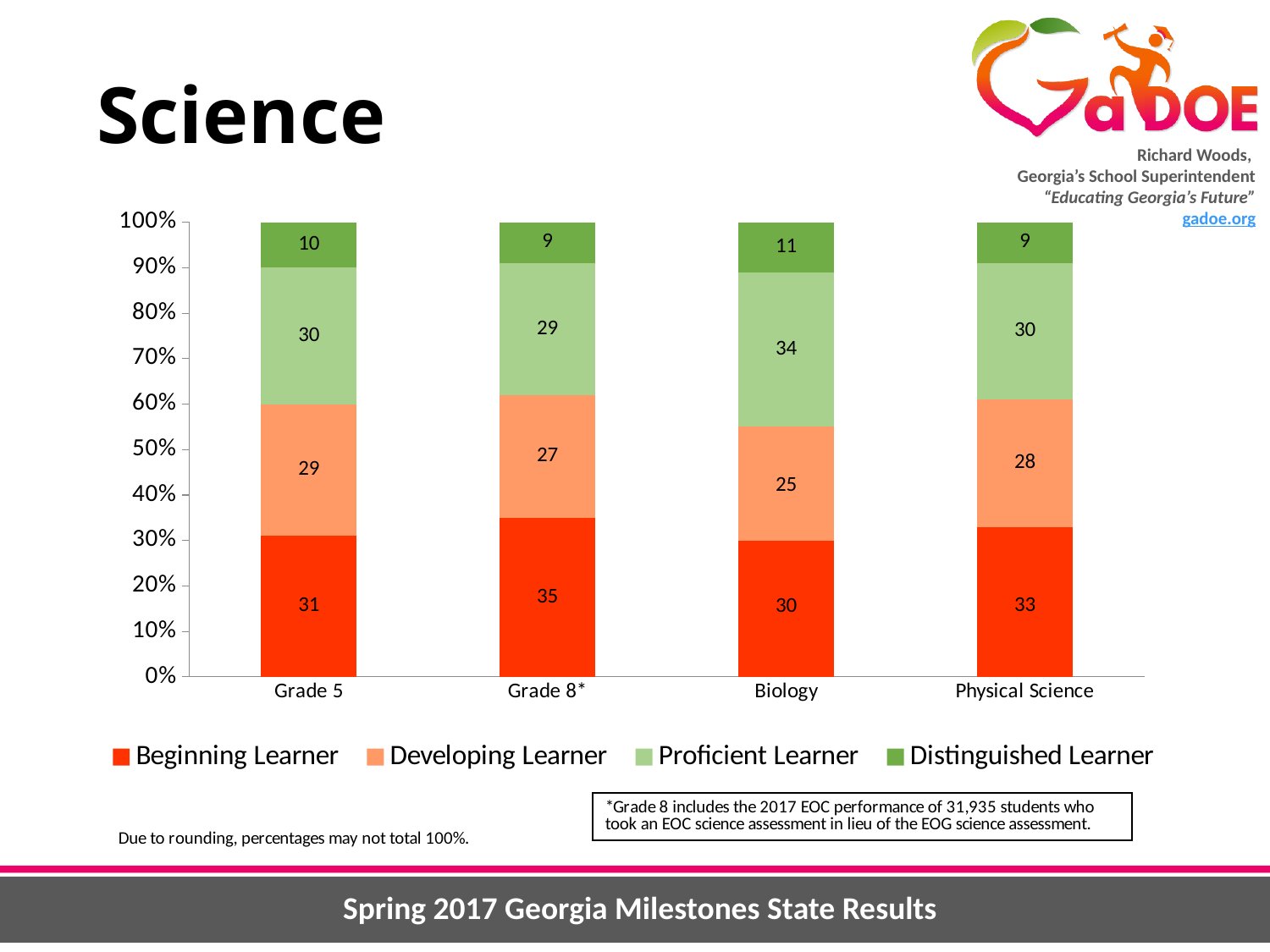
What is the Distinguished Learner value for Physical Science? 9 What is the Beginning Learner value for Grade 8*? 35 Which is larger, the Distinguished Learner value for Biology or for Grade 5? Biology Which category has the highest Beginning Learner value? Grade 8* What is the total of the stacked bar for Physical Science? 100 What is the Developing Learner value for Grade 5? 29 How many categories are shown on the x axis? 4 How many series does the legend list? 4 What is the difference between the Proficient Learner values for Biology and Grade 8*? 5 What is the Proficient Learner value for Biology? 34 Which category has the lowest Developing Learner value? Biology What kind of chart is shown on the slide? Stacked bar chart